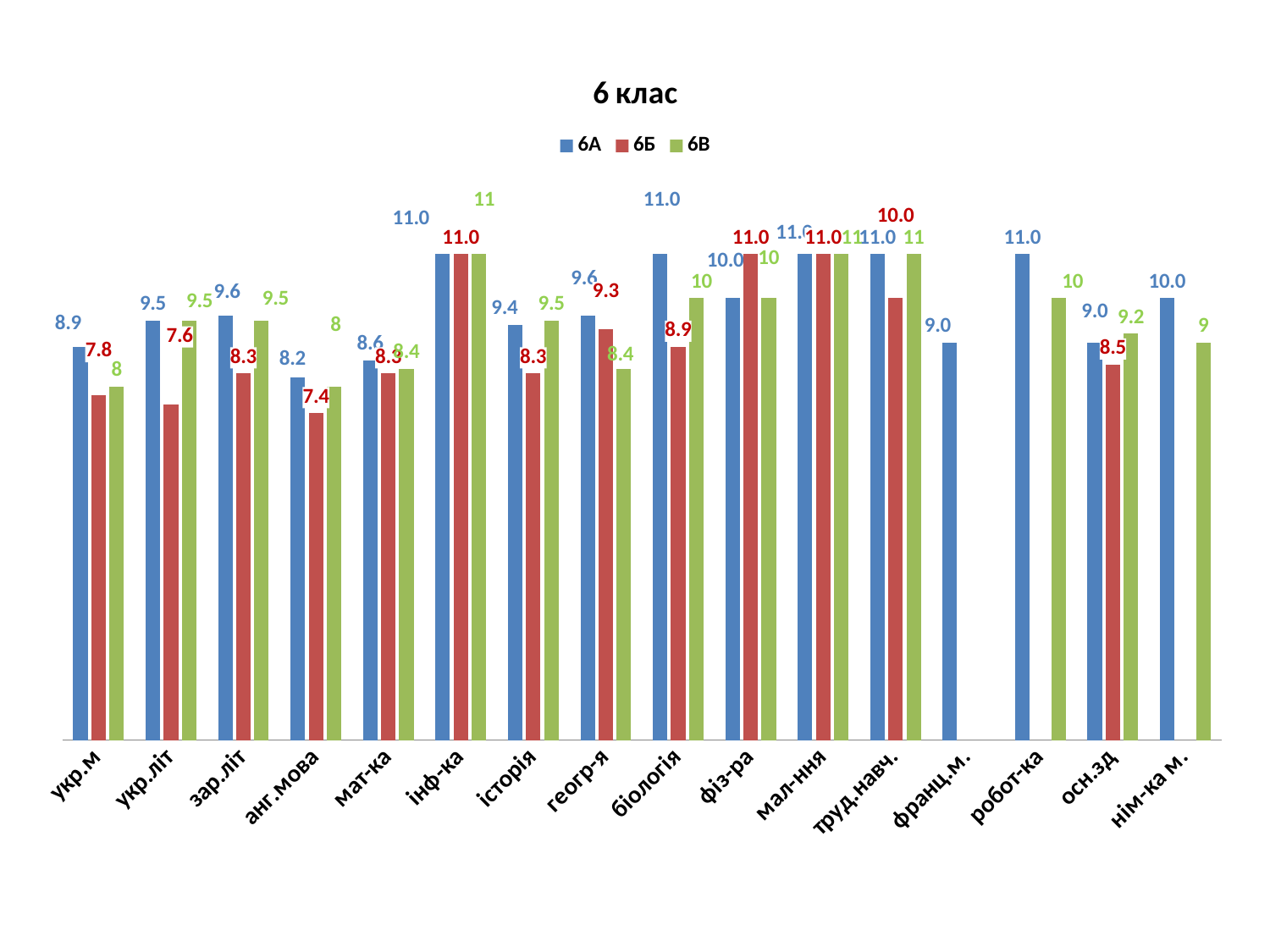
What kind of chart is shown on the slide? bar chart How many series does the legend list? 3 What is the difference between the 6А and 6Б values in біологія? 2.1 What is the value for 6Б in геогр-я? 9.3 Which is larger in укр.літ, the value for 6Б or for 6В? 6В What is the value for 6А in укр.м? 8.9 What is the value for 6Б in анг.мова? 7.4 Which category has the lowest value for 6Б? анг.мова What is the value for 6В in осн.зд? 9.2 What is the title of the chart? 6 клас Which is larger in фіз-ра, the value for 6А or for 6Б? 6Б How many categories are shown on the x axis? 16